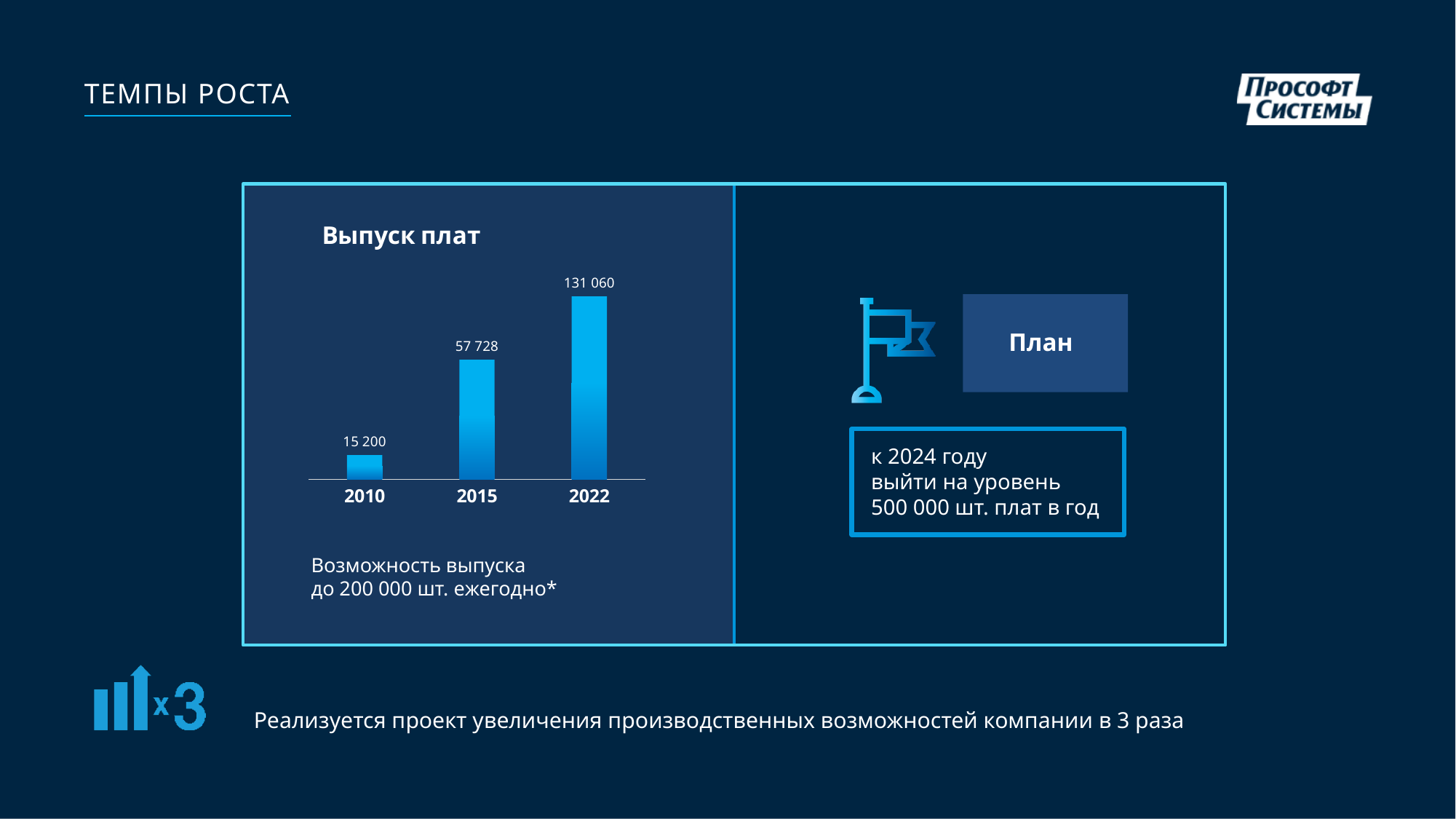
Do the values in the 'Выпуск плат' chart rise or fall from 2010 to 2022? Rise What is the difference between the 2022 and 2015 values in the 'Выпуск плат' chart? 73 332 What is the value for 2010 in the 'Выпуск плат' chart? 15 200 What is the value for 2022 in the 'Выпуск плат' chart? 131 060 What kind of chart is 'Выпуск плат'? Bar chart Which year has the highest value in the 'Выпуск плат' chart? 2022 What is the difference between the 2015 and 2010 values in the 'Выпуск плат' chart? 42 528 What is the value for 2015 in the 'Выпуск плат' chart? 57 728 How many years (bars) are shown in the 'Выпуск плат' chart? 3 Which year has the lowest value in the 'Выпуск плат' chart? 2010 What is the title of the chart on the slide? Выпуск плат In the 'Выпуск плат' chart, which is larger: the value for 2015 or the value for 2010? 2015